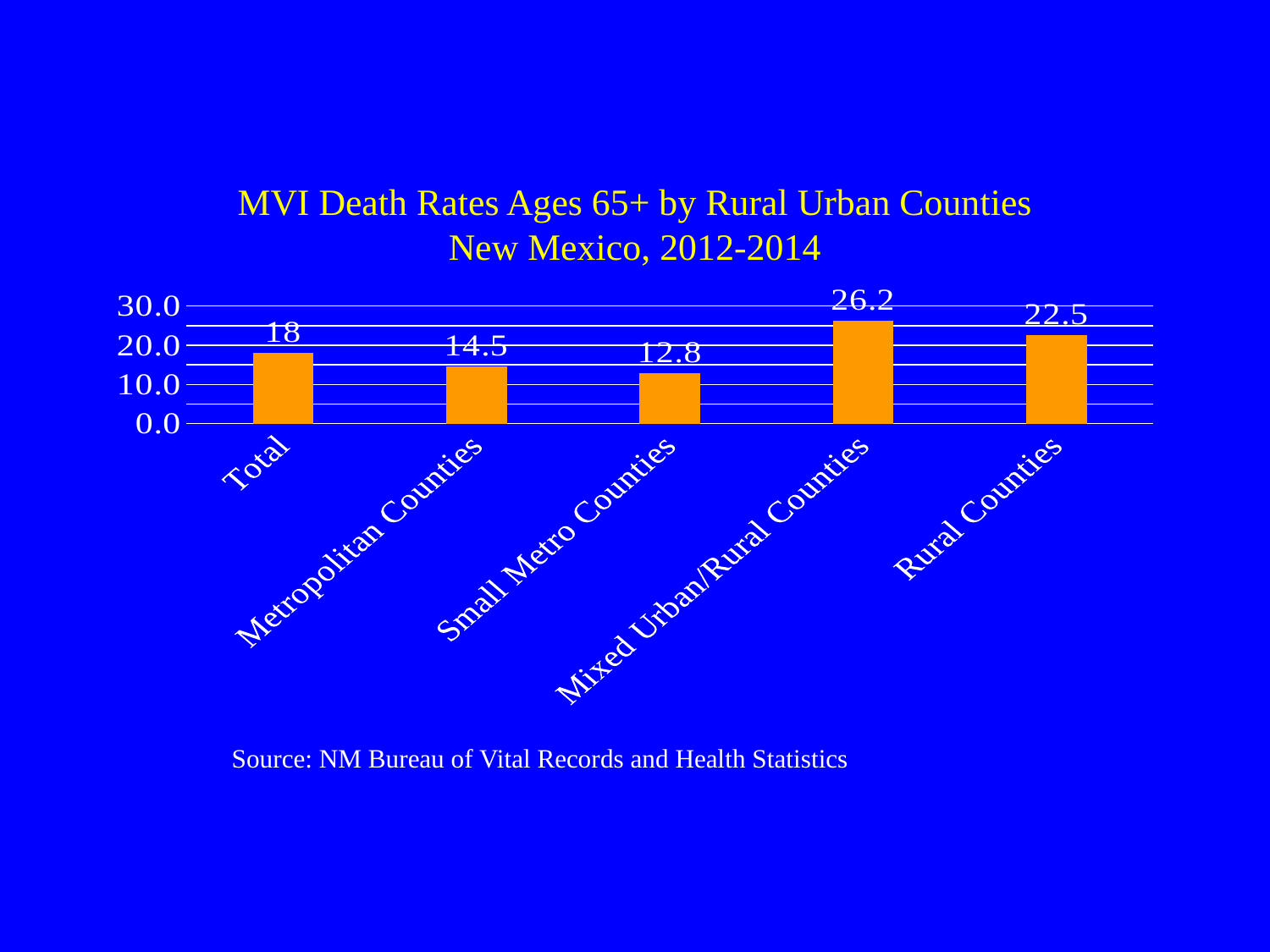
What is the MVI death rate for Metropolitan Counties? 14.5 How many categories are shown on the x axis? 5 What kind of chart is shown on the slide? Bar chart What is the MVI death rate for Total? 18 Which category has the highest MVI death rate? Mixed Urban/Rural Counties What is the MVI death rate for Rural Counties? 22.5 What is the title of the chart? MVI Death Rates Ages 65+ by Rural Urban Counties New Mexico, 2012-2014 What is the difference between the MVI death rates for Mixed Urban/Rural Counties and Rural Counties? 3.7 What is the MVI death rate for Small Metro Counties? 12.8 What is the MVI death rate for Mixed Urban/Rural Counties? 26.2 Which category has the lowest MVI death rate? Small Metro Counties Which has a higher MVI death rate, Metropolitan Counties or Rural Counties? Rural Counties